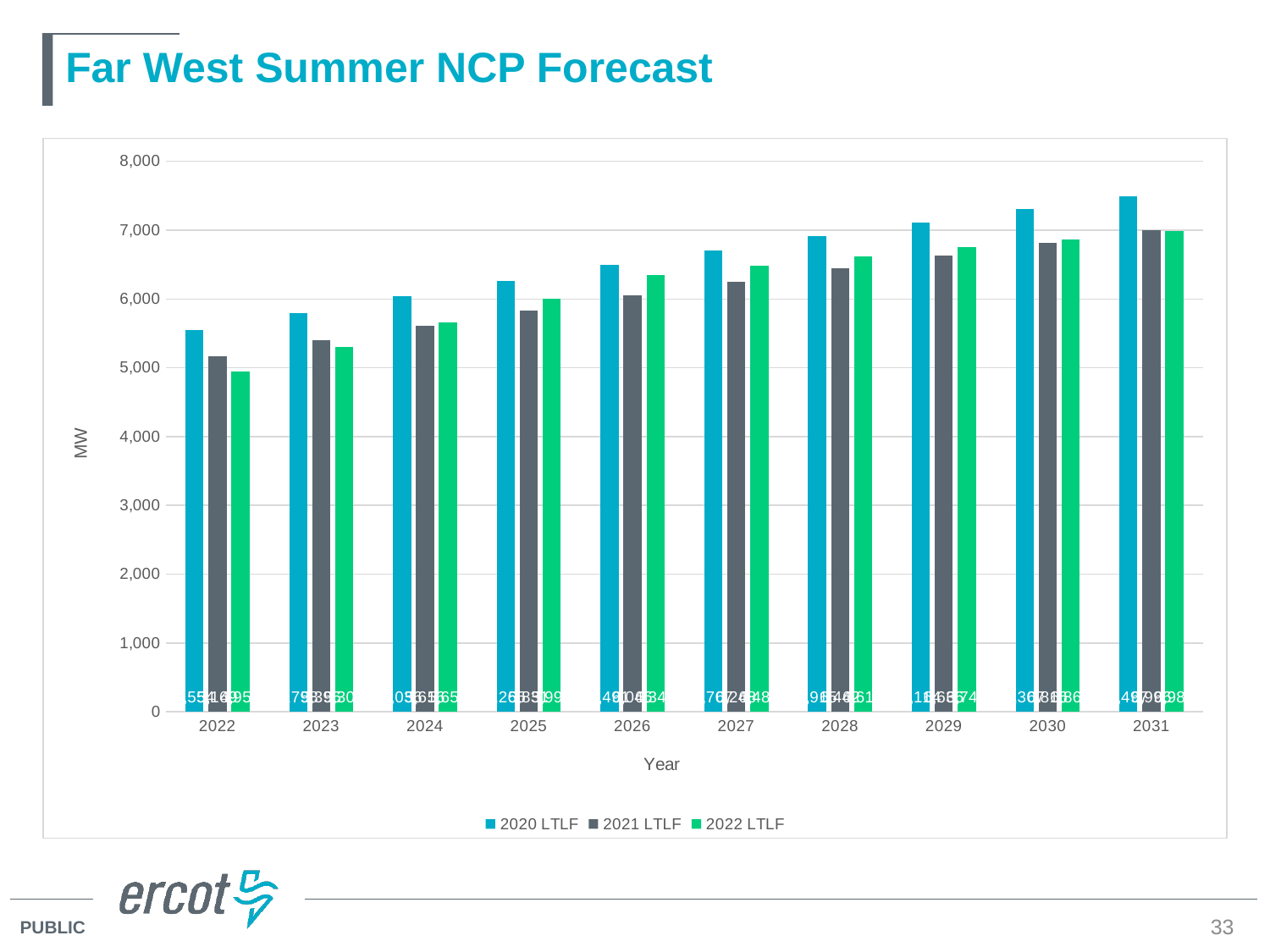
In which year is the 2020 LTLF value highest? 2031 How many years are shown on the x axis? 10 Is the 2021 LTLF value for 2022 greater or less than 5,000? greater What kind of chart is shown on the slide? bar chart What is the label on the y axis? MW For 2025, which is larger: the 2021 LTLF value or the 2022 LTLF value? 2022 LTLF Is the 2020 LTLF value for 2031 greater or less than 7,000? greater For 2022, which is larger: the 2020 LTLF value or the 2022 LTLF value? 2020 LTLF How many series does the legend list? 3 In which year is the 2022 LTLF value lowest? 2022 Do the 2020 LTLF values rise or fall from 2022 to 2031? rise